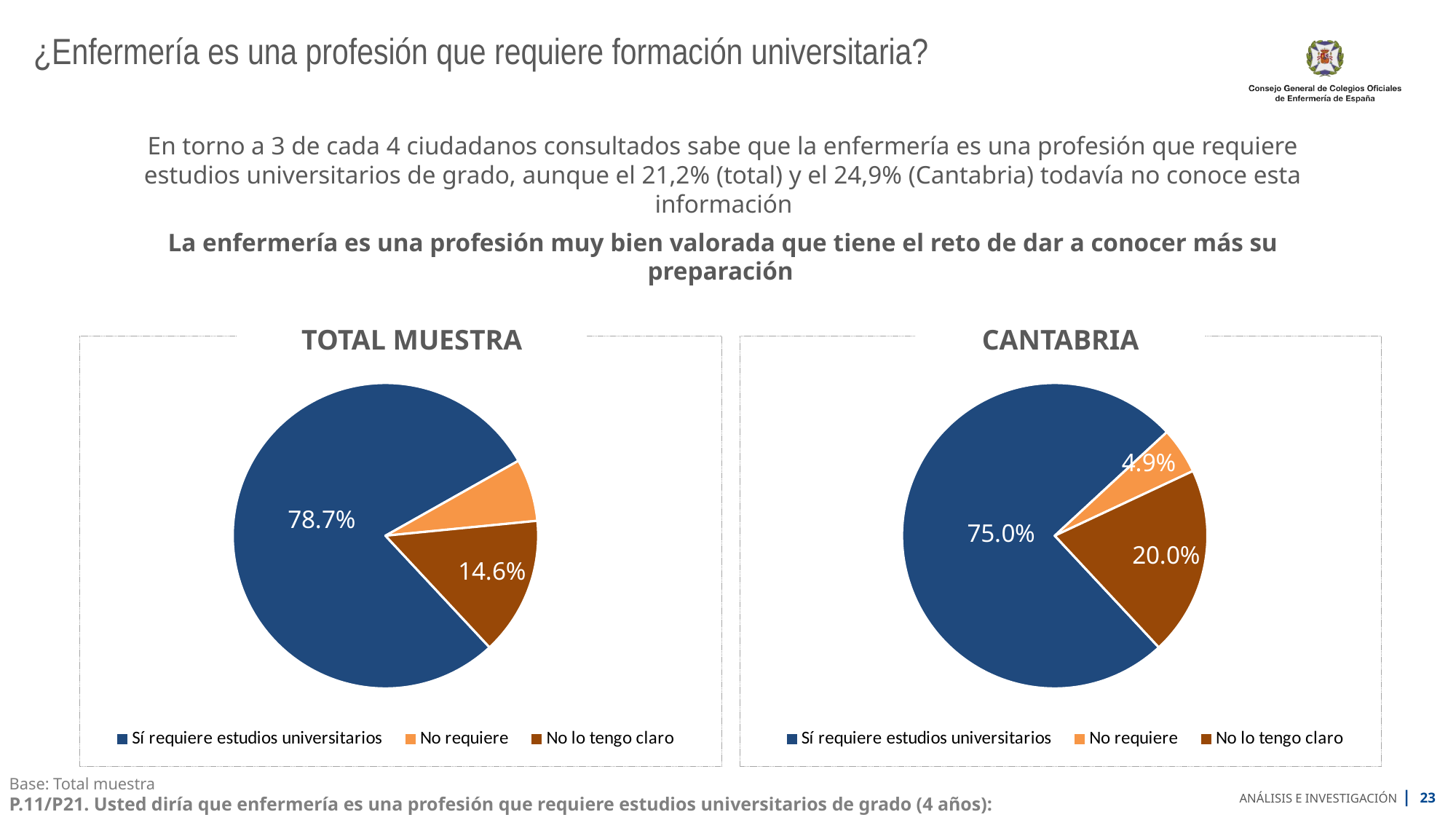
In the CANTABRIA chart, what colour is the 'No requiere' slice? Orange In the CANTABRIA chart, what percentage of respondents answered 'No lo tengo claro'? 20.0% In the TOTAL MUESTRA chart, what percentage of respondents answered 'No lo tengo claro'? 14.6% In the TOTAL MUESTRA chart, which category has the largest slice? Sí requiere estudios universitarios In the CANTABRIA chart, what is the difference in percentage points between 'Sí requiere estudios universitarios' and 'No lo tengo claro'? 55.0 percentage points Which chart shows a larger share for 'No lo tengo claro', TOTAL MUESTRA or CANTABRIA? CANTABRIA In the CANTABRIA chart, which category has the smallest slice? No requiere In the CANTABRIA chart, what percentage of respondents answered 'Sí requiere estudios universitarios'? 75.0% In the TOTAL MUESTRA chart, what percentage of respondents answered 'Sí requiere estudios universitarios'? 78.7% What type of chart is used for CANTABRIA? Pie chart In the CANTABRIA chart, what percentage of respondents answered 'No requiere'? 4.9% How many categories does the legend of the TOTAL MUESTRA chart list? 3